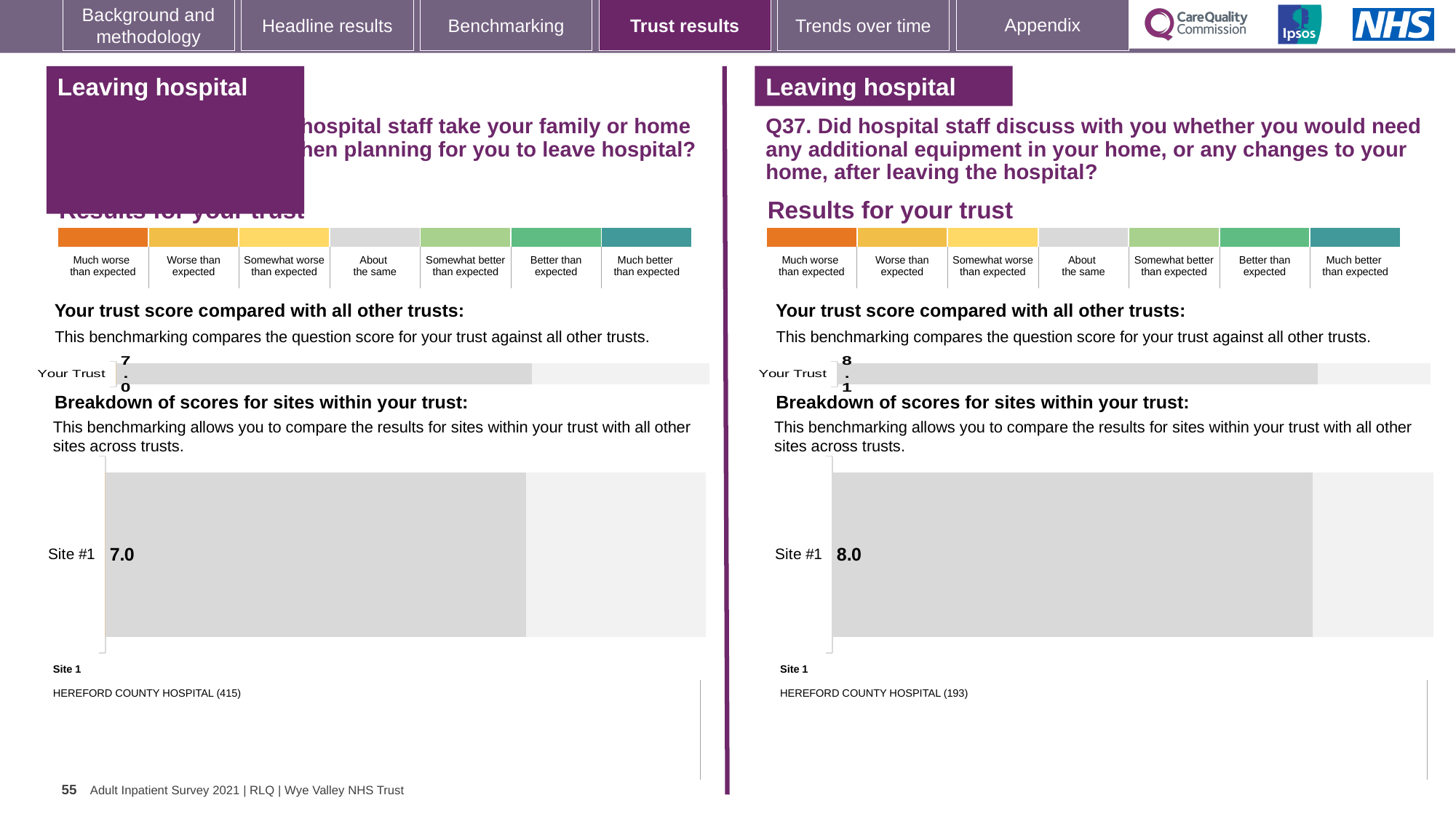
On the left half of the slide, what value is shown for 'Your Trust' in the 'Your trust score compared with all other trusts' chart? 7.0 What is the difference between the 'Your Trust' score on the right half (Q37) and the 'Your Trust' score on the left half of the slide? 1.1 On the left half of the slide, what score is shown for Site #1 in the 'Breakdown of scores for sites within your trust' chart? 7.0 Which site is listed as Site 1 beneath the charts on the right half of the slide (Q37)? HEREFORD COUNTY HOSPITAL (193) Which site is listed as Site 1 beneath the charts on the left half of the slide? HEREFORD COUNTY HOSPITAL (415) What is the difference between the 'Your Trust' score (8.1) and the Site #1 score (8.0) on the right half of the slide (Q37)? 0.1 How many sites are plotted in the 'Breakdown of scores for sites within your trust' chart on the right half of the slide (Q37)? 1 On the left half of the slide, is the Site #1 score greater or less than the 'Your Trust' score on the right half (Q37)? less On the right half of the slide (Q37), what score is shown for Site #1 in the 'Breakdown of scores for sites within your trust' chart? 8.0 What type of chart is used to show the Site #1 score on each half of the slide? Bar chart On the right half of the slide (Q37), what value is shown for 'Your Trust' in the 'Your trust score compared with all other trusts' chart? 8.1 Which is larger: the Site #1 score on the left half of the slide or the Site #1 score on the right half (Q37)? Right half (Q37), 8.0